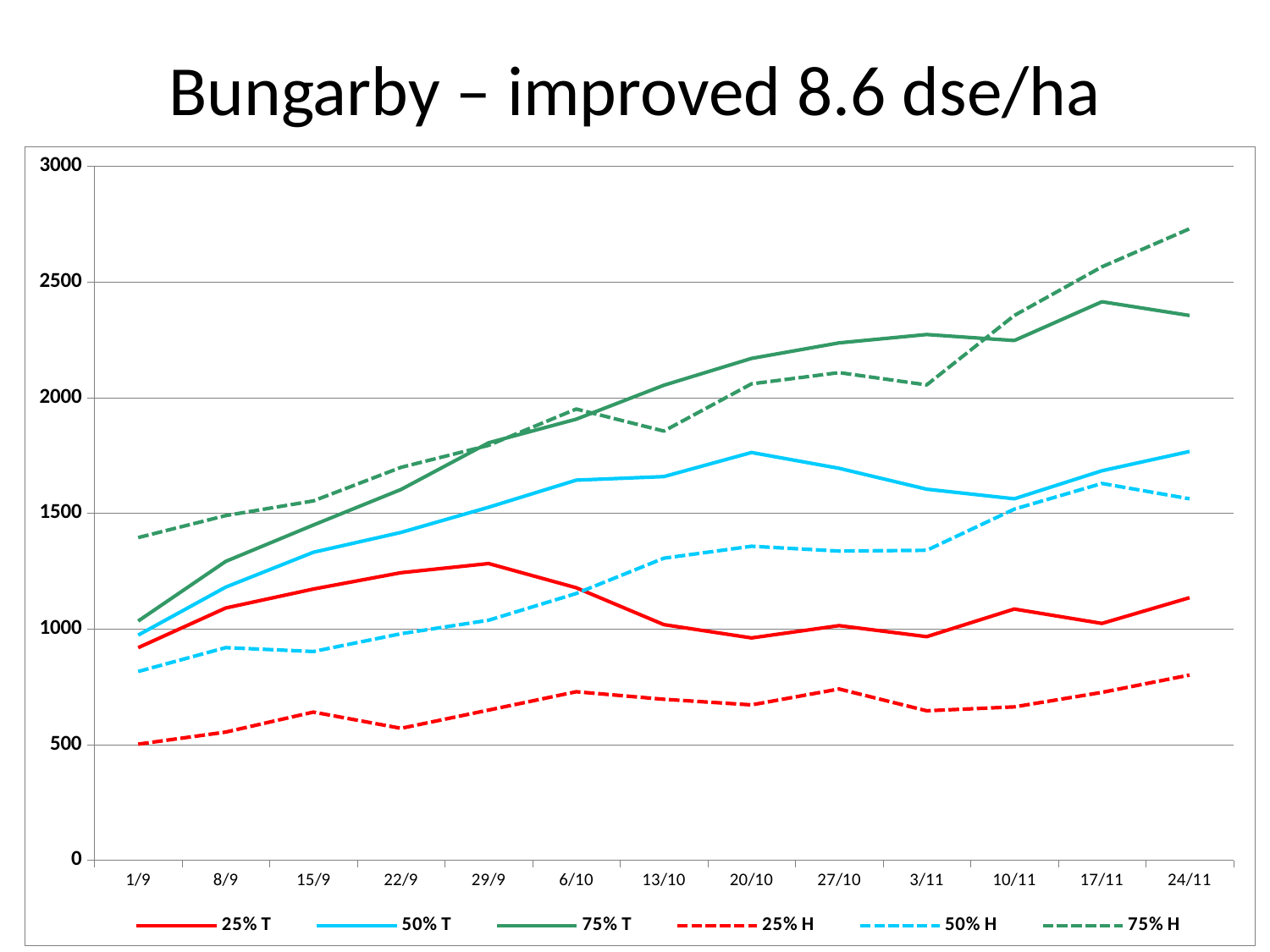
Is the value for 75% H at 24/11 greater or less than 2500? greater Is the value for 25% H at 1/9 greater or less than 1000? less What is the title of the slide? Bungarby – improved 8.6 dse/ha Is the value for 50% T at 20/10 greater or less than 1500? greater How many series does the legend list? 6 Which series has the lowest value at 1/9? 25% H Which legend entries are drawn with dashed lines? 25% H, 50% H, 75% H At 24/11, which is larger: 75% H or 75% T? 75% H What kind of chart is shown on the slide? line chart Does the 75% T series rise or fall overall from 1/9 to 24/11? rise How many dates are shown along the x axis? 13 Which series has the highest value at 24/11? 75% H